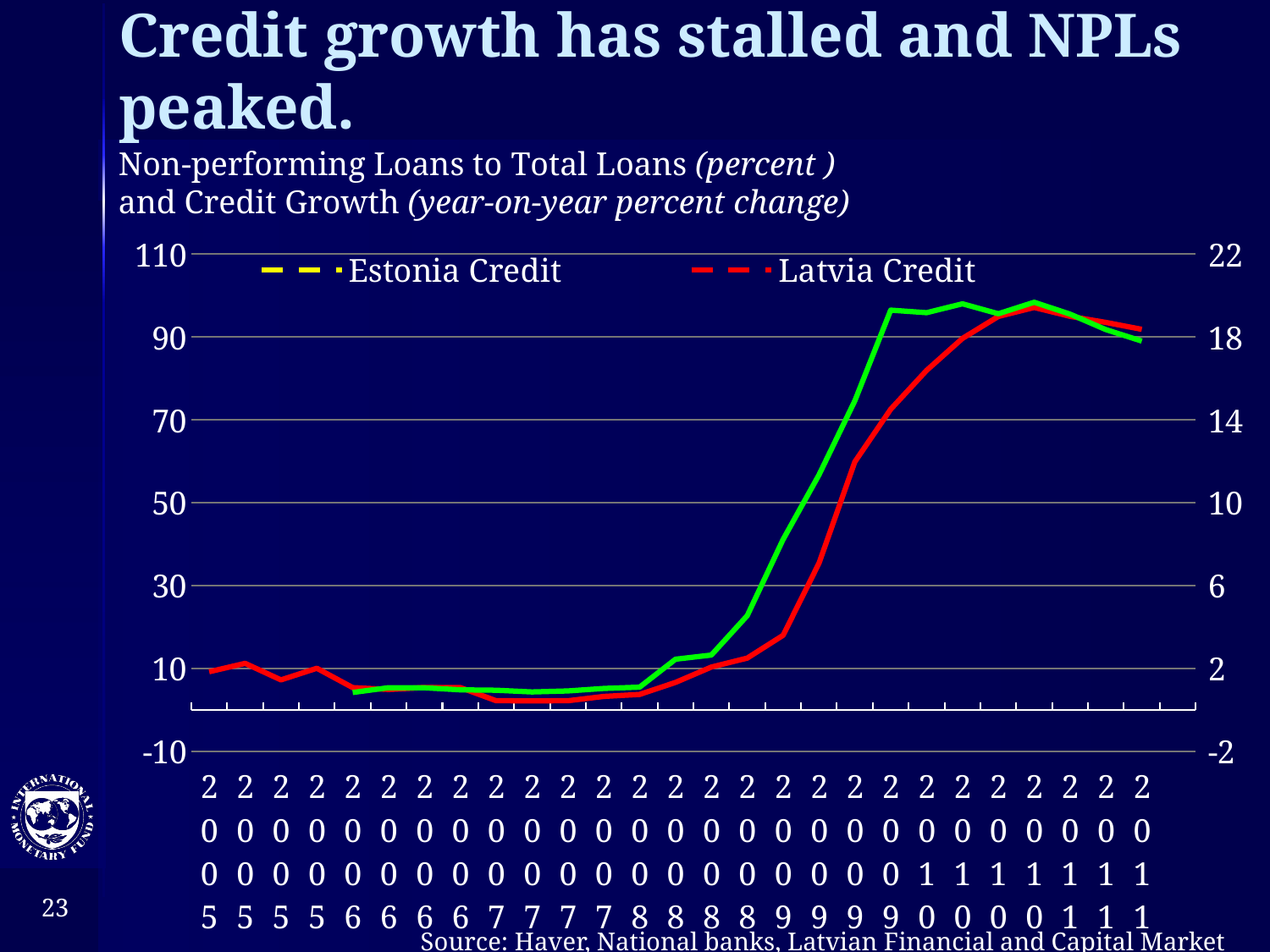
Is the peak of the green line greater or less than 90 on the left axis? greater Is the value of the red line in 2007 greater or less than 10 on the left axis? less Which line is higher in 2009, the green line or the red line? the green line What kind of chart is shown on the slide? line chart How many points are labelled along the x axis of the chart? 27 What is the highest tick value shown on the right vertical axis? 22 How many series does the chart legend list? 2 What are the two series named in the chart legend? Estonia Credit and Latvia Credit Do the plotted lines generally rise or fall from 2005 to 2010? rise What is the highest tick value shown on the left vertical axis? 110 What is the lowest tick value shown on the right vertical axis? -2 What colour is the Latvia Credit entry in the legend? red